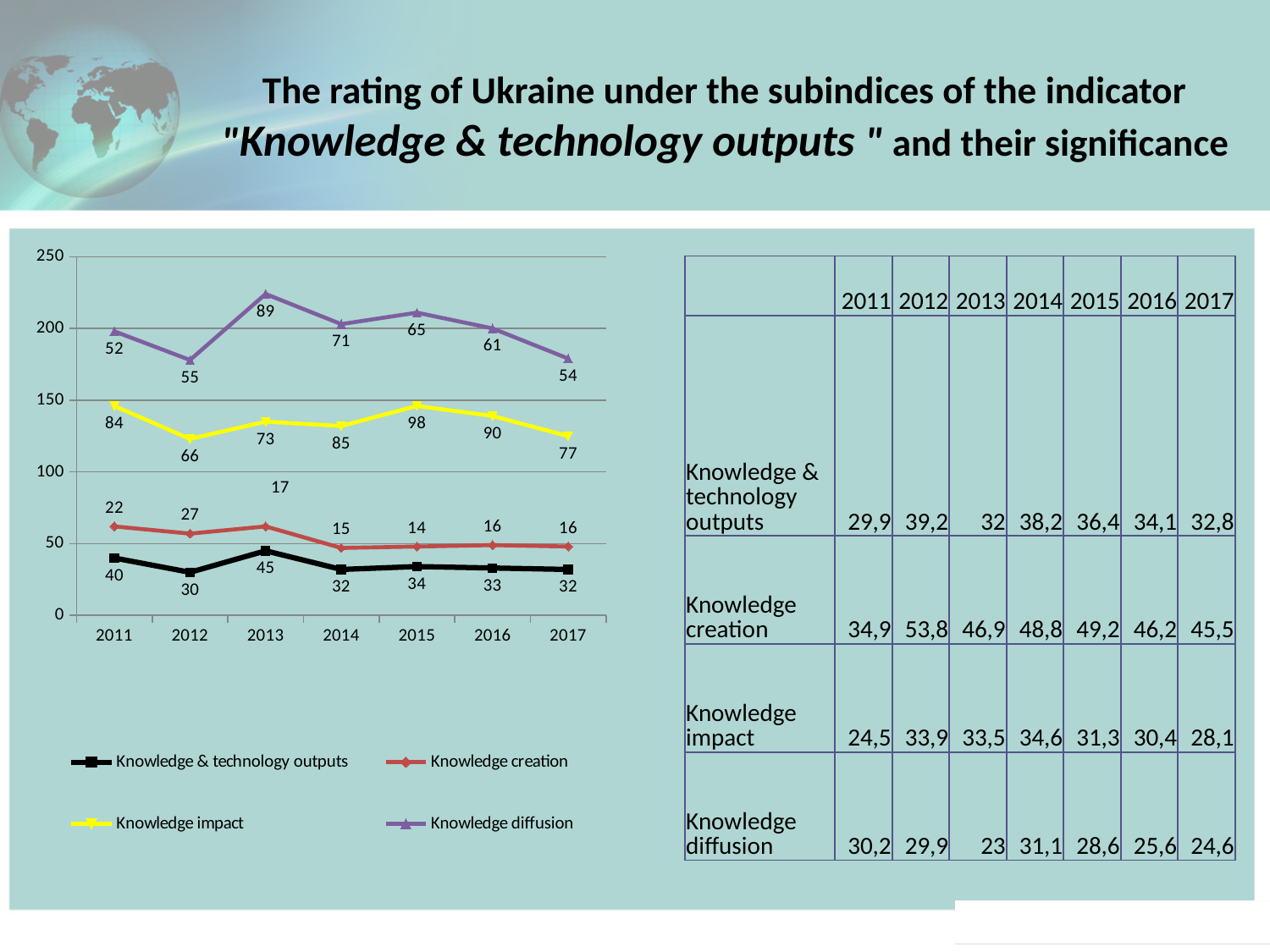
What is the data label for Knowledge creation in 2012? 27 What kind of chart is shown on the slide? line chart How many series does the chart legend list? 4 Do the labelled values for Knowledge diffusion rise or fall from 2013 to 2017? fall What is the difference between the Knowledge impact labels for 2015 and 2012? 32 Which has the larger labelled value in 2015: Knowledge impact or Knowledge diffusion? Knowledge impact In which year does Knowledge & technology outputs have its lowest labelled value? 2012 What is the data label for Knowledge diffusion in 2013? 89 How many years are shown on the x axis of the chart? 7 What is the data label for Knowledge & technology outputs in 2013? 45 In which year does Knowledge impact have its highest labelled value? 2015 What is the data label for Knowledge impact in 2015? 98